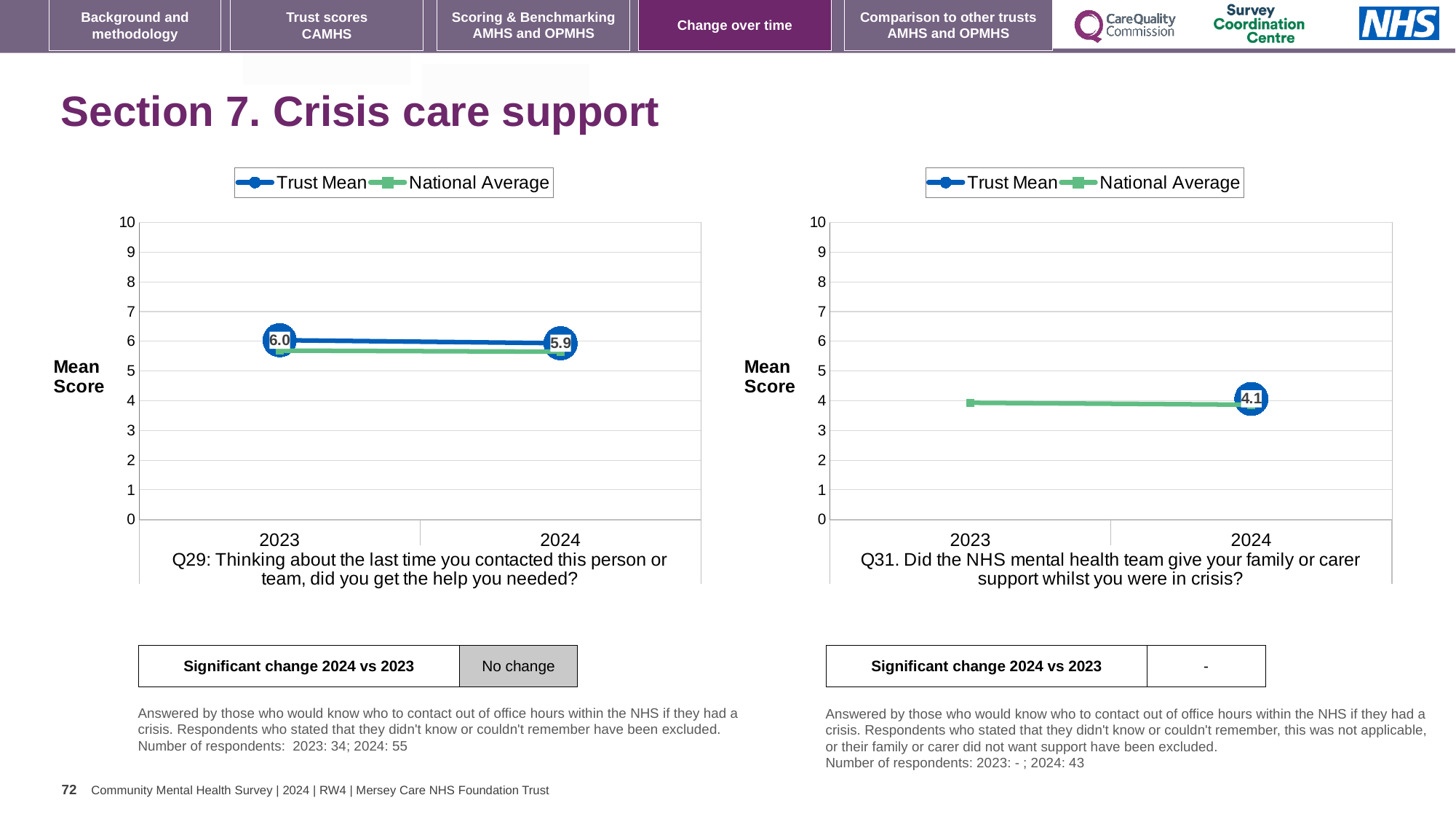
In the left chart (Q29), what is the Trust Mean score for 2023? 6.0 In the right chart (Q31), what is the Trust Mean score for 2024? 4.1 What are the two series named in the legend of the left chart (Q29)? Trust Mean and National Average In the left chart (Q29), by how much did the Trust Mean change from 2023 to 2024? decreased by 0.1 In the left chart (Q29), what is the Trust Mean score for 2024? 5.9 In the left chart (Q29), which is larger in 2023: the Trust Mean or the National Average? Trust Mean How many years are shown on the x axis of the left chart (Q29)? 2 In the right chart (Q31), is the National Average value for 2023 greater or less than 5? less In the left chart (Q29), does the Trust Mean rise or fall from 2023 to 2024? fall How many series does the legend of the right chart (Q31) list? 2 What kind of chart is the left chart (Q29)? line chart In the left chart (Q29), is the National Average value for 2023 greater or less than 5? greater